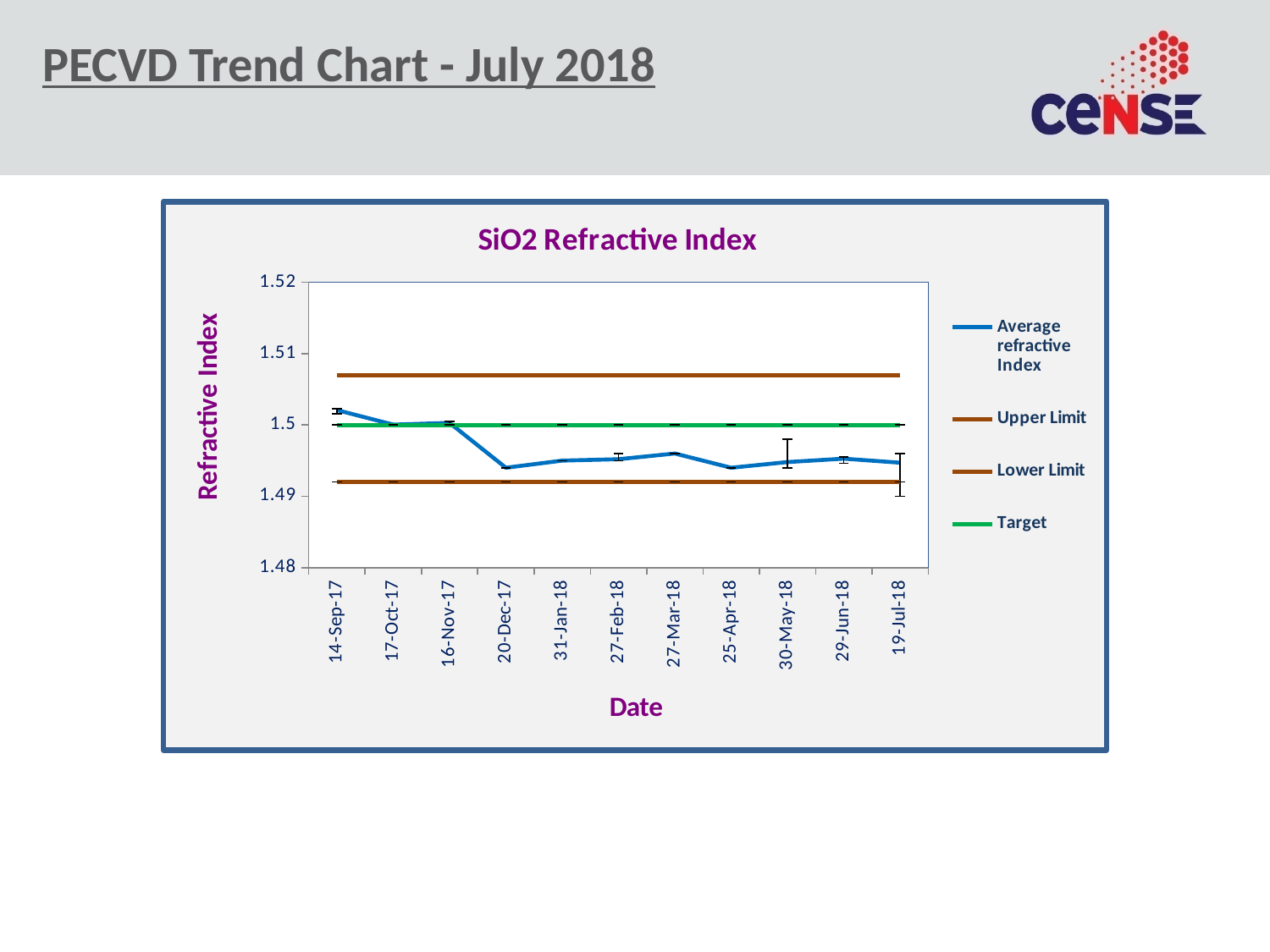
Is the Upper Limit greater or less than 1.5? greater Which has the larger Average refractive Index, 14-Sep-17 or 20-Dec-17? 14-Sep-17 What kind of chart is shown on the slide? Line chart Is the Lower Limit greater or less than 1.5? less How many dates are plotted along the x axis? 11 What is the title of the chart? SiO2 Refractive Index On which date is the Average refractive Index highest? 14-Sep-17 Is the Average refractive Index for 20-Dec-17 greater or less than 1.5? less What value does the Target line sit at? 1.5 How many series does the legend list? 4 What is the label of the y axis? Refractive Index